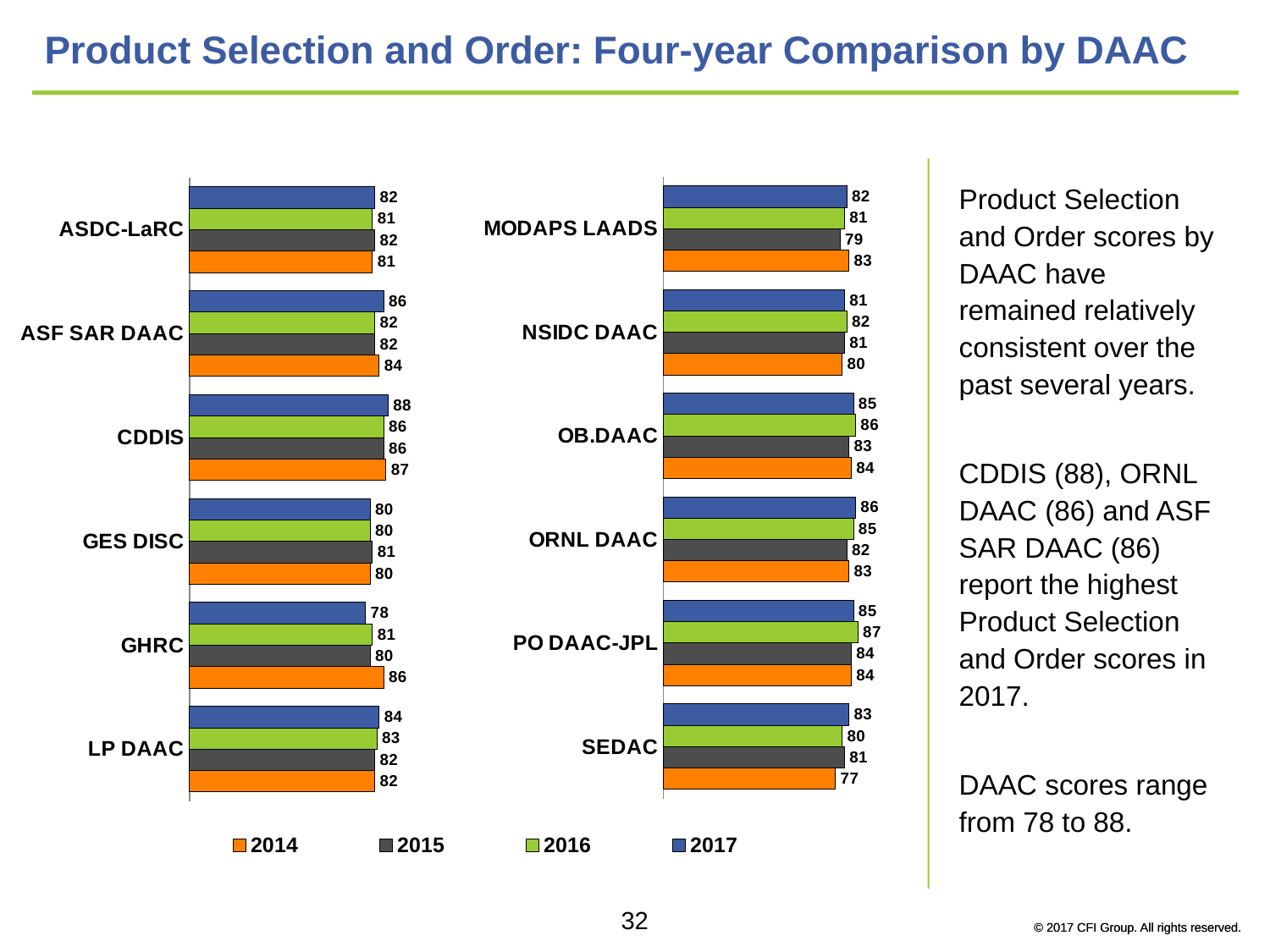
In the right chart, which is larger for PO DAAC-JPL: the 2016 value or the 2017 value? 2016 In the left chart, what is the 2017 value for CDDIS? 88 In the left chart, which category has the lowest 2017 value? GHRC In the left chart, what is the 2016 value for GHRC? 81 In the left chart, which category has the highest 2017 value? CDDIS How many categories are shown in the right chart? 6 In the right chart, which category has the lowest 2014 value? SEDAC In the left chart, what is the difference between the 2014 and 2017 values for GHRC? 8 What kind of chart is shown on the slide? Bar chart In the right chart, what is the 2014 value for SEDAC? 77 In the right chart, what is the 2015 value for MODAPS LAADS? 79 How many series does the legend list? 4